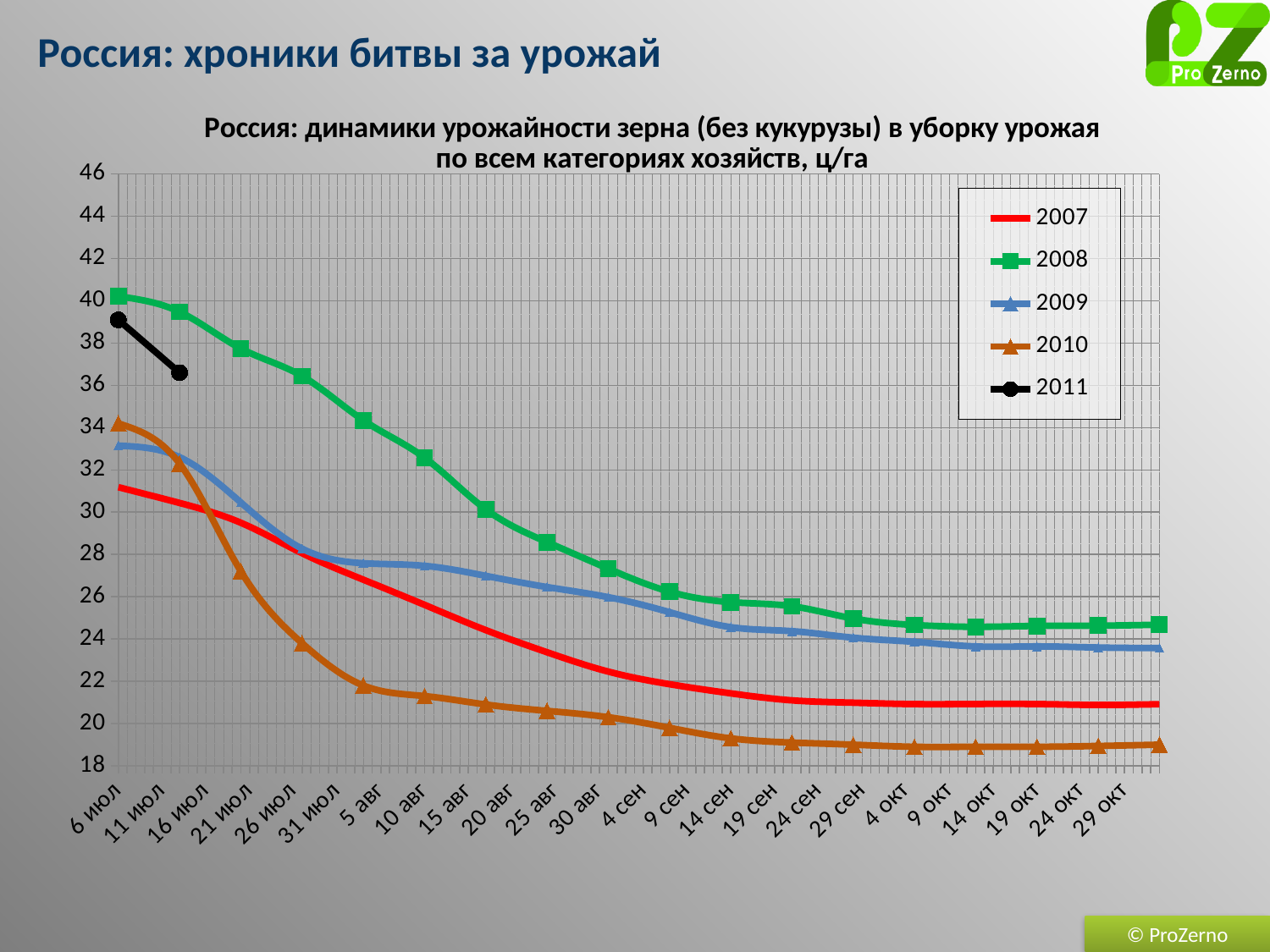
Is the value for 2011 at 11 июл greater or less than 38? less Which series has the highest value at 29 окт? 2008 Which years are listed in the legend? 2007, 2008, 2009, 2010, 2011 Which series has the lowest value at 29 окт? 2010 Do the values for the 2008 series rise or fall along the x axis? fall What colour is the line for the 2011 series? black How many series does the legend list? 5 What kind of chart is shown on the slide? line chart Is the value for 2008 at 6 июл greater or less than 38? greater Is the value for 2010 at 29 окт greater or less than 20? less At 6 июл, which is larger: the value for 2008 or the value for 2007? 2008